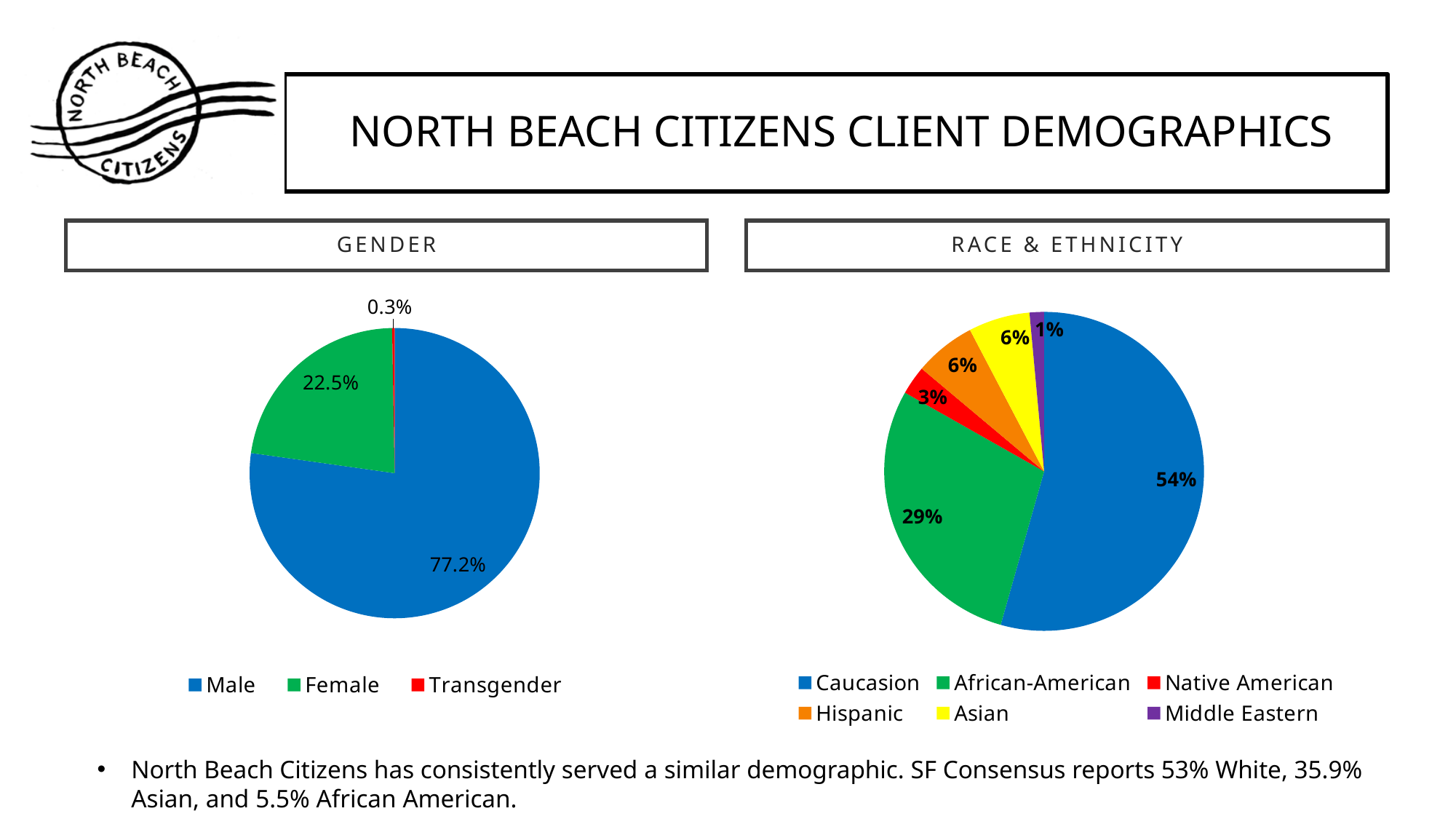
What type of chart is the Gender chart? Pie chart In the Race & Ethnicity chart, which category has the largest share? Caucasion In the Gender chart, which category has the smallest share? Transgender In the Gender chart, what is the difference between the Male and Female percentages? 54.7% In the Gender chart, what percentage of clients are Male? 77.2% In the Race & Ethnicity chart, what percentage of clients are Native American? 3% In the Gender chart, what percentage of clients are Female? 22.5% In the Gender chart, what percentage of clients are Transgender? 0.3% In the Race & Ethnicity chart, what percentage of clients are Caucasion? 54% In the Race & Ethnicity chart, what percentage of clients are African-American? 29% In the Race & Ethnicity chart, which is larger, the share for Hispanic or the share for Native American? Hispanic How many categories does the legend of the Race & Ethnicity chart list? 6